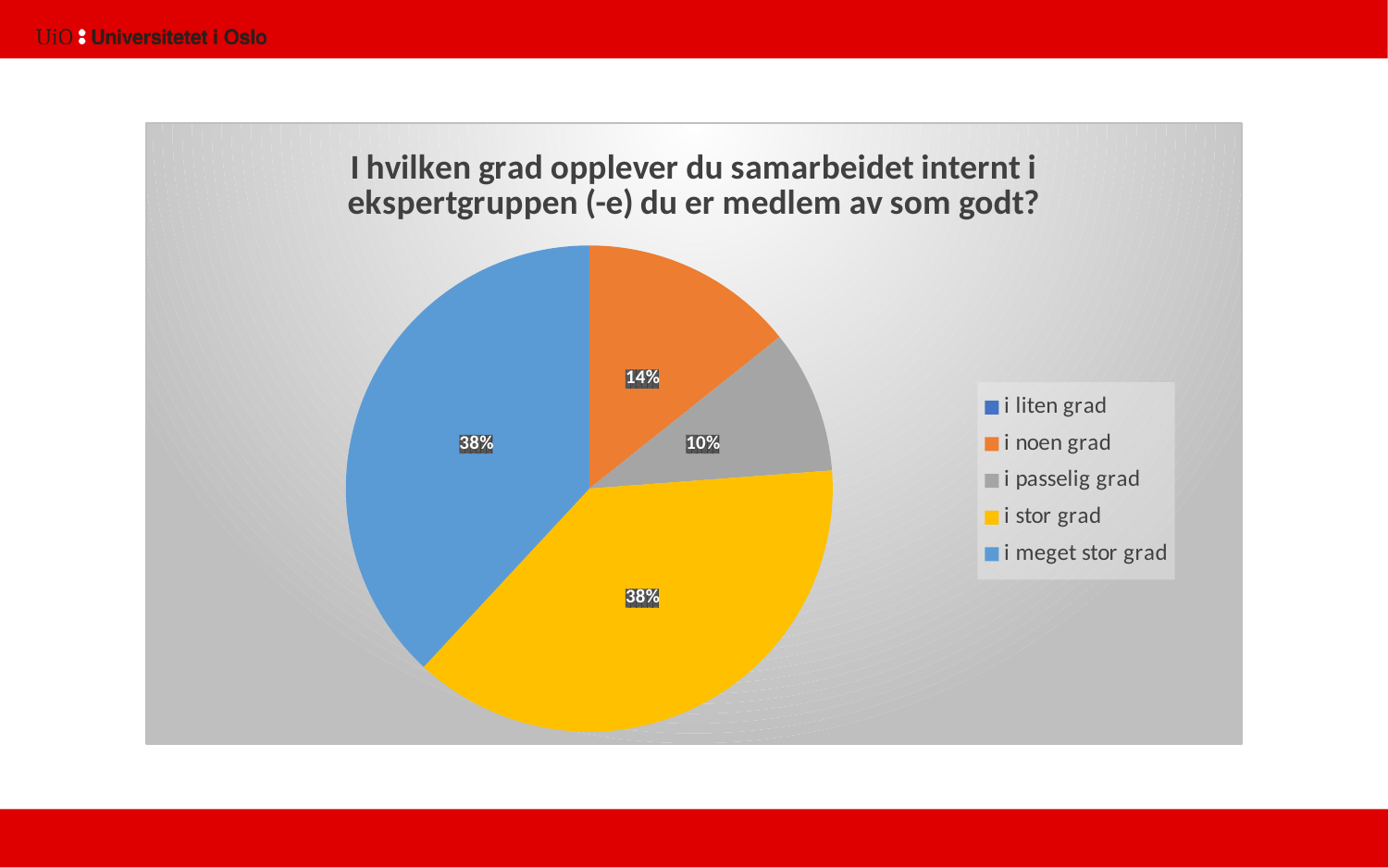
What percentage is shown for "i noen grad"? 14% How many entries does the legend list? 5 What percentage is shown for "i meget stor grad"? 38% What percentage is shown for "i stor grad"? 38% What percentage is shown for "i passelig grad"? 10% What kind of chart is shown on the slide? pie chart Which is larger, the share for "i noen grad" or the share for "i passelig grad"? i noen grad What colour is the slice for "i stor grad"? yellow How many slices with a visible data label does the pie chart have? 4 Which labelled slice of the pie has the smallest share? i passelig grad What is the difference in percentage points between "i noen grad" and "i passelig grad"? 4 What is the combined share of "i stor grad" and "i meget stor grad"? 76%